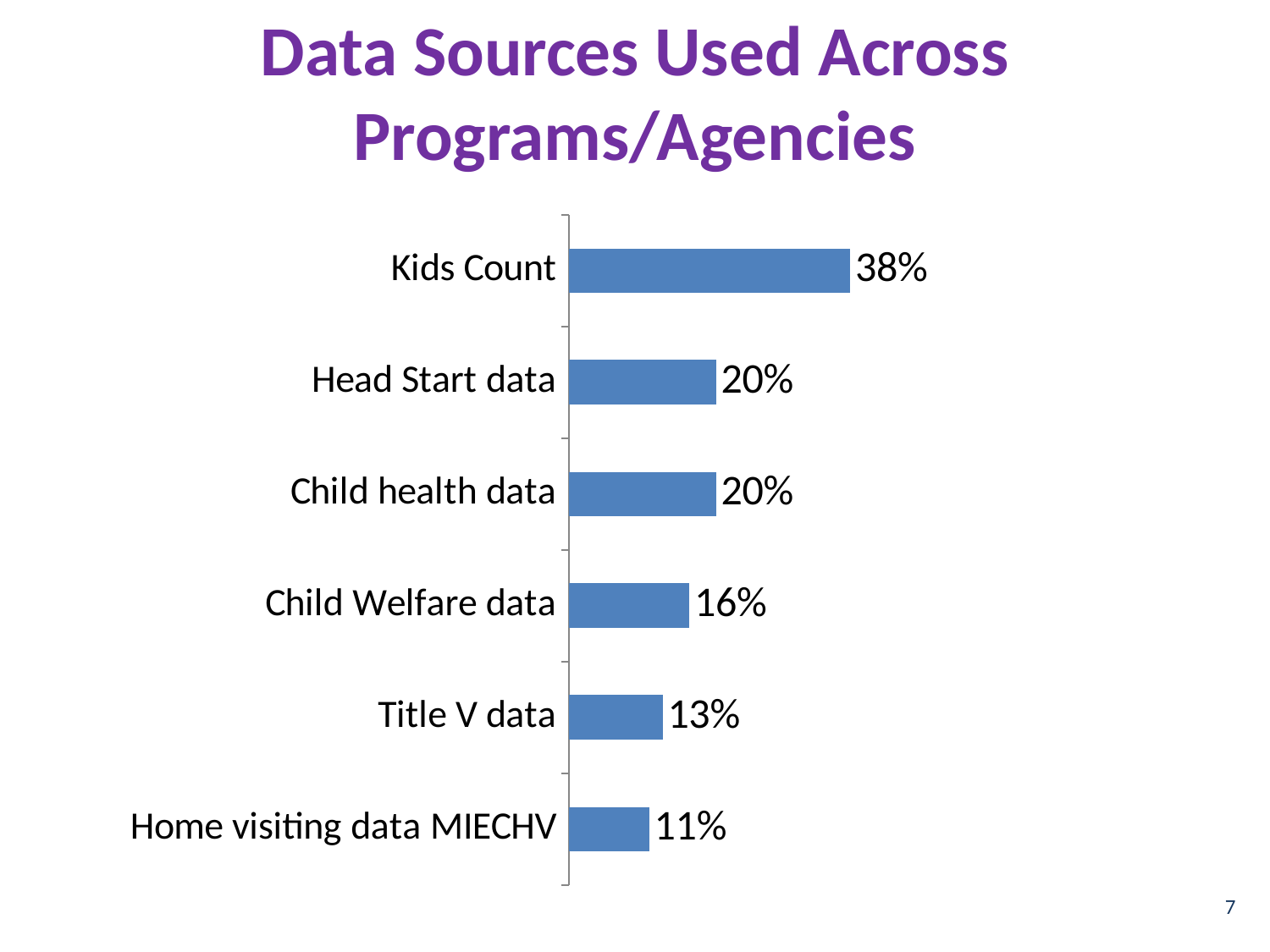
What percentage is shown for Kids Count? 38% How many data sources are shown in the chart? 6 What percentage is shown for Child Welfare data? 16% Which data source has the highest percentage? Kids Count What is the difference between the values for Kids Count and Head Start data? 18% What kind of chart is shown on the slide? Bar chart What is the value for Title V data? 13% Which data source has the lowest percentage? Home visiting data MIECHV What is the value for Home visiting data MIECHV? 11% Which is larger, the value for Child health data or the value for Child Welfare data? Child health data What is the difference between the values for Child Welfare data and Title V data? 3% What is the title of the slide? Data Sources Used Across Programs/Agencies